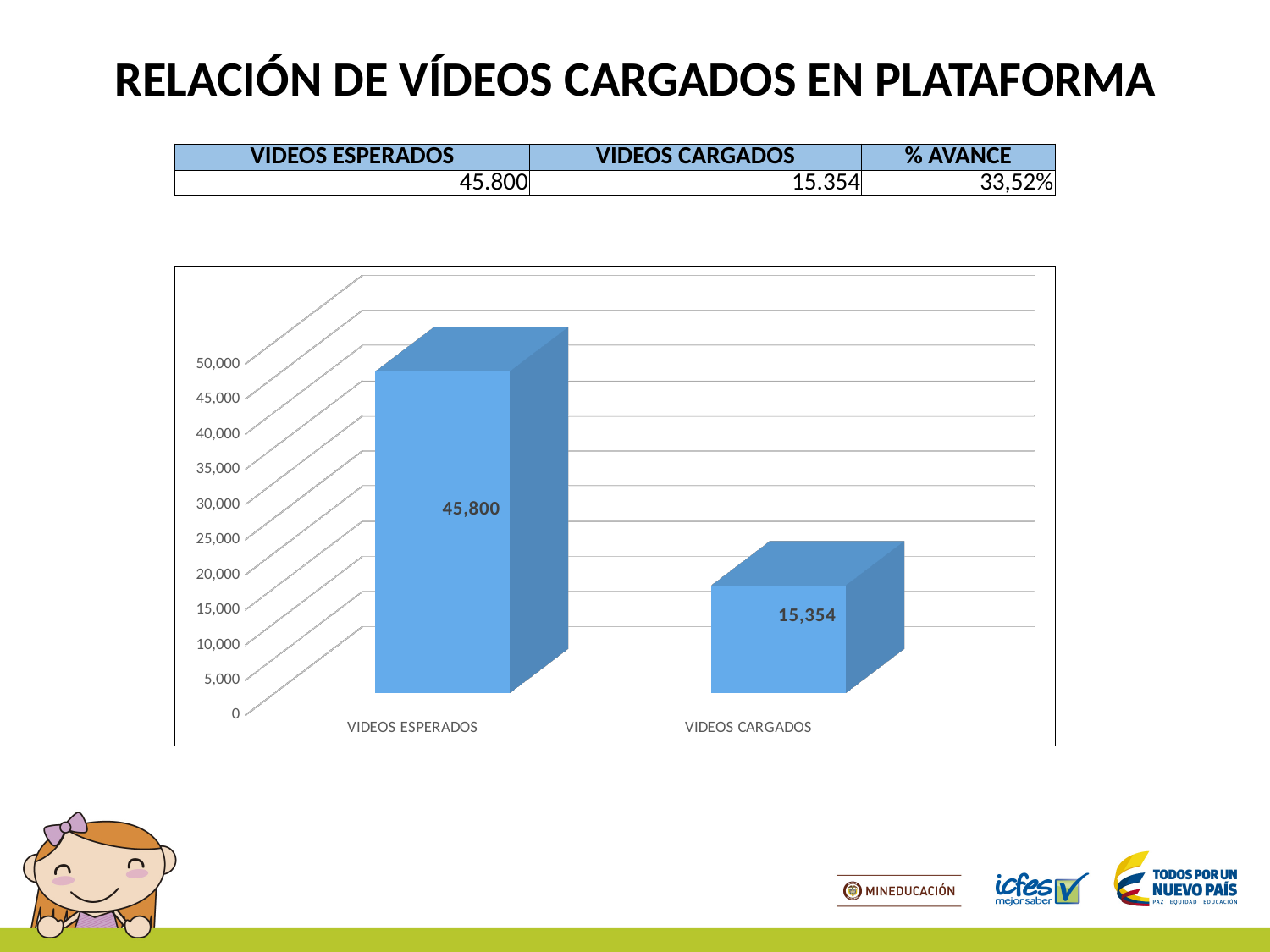
What is the value for VIDEOS CARGADOS in the chart? 15,354 What kind of chart is shown on the slide? bar chart What is the title of the slide containing the chart? RELACIÓN DE VÍDEOS CARGADOS EN PLATAFORMA What is the difference between the values for VIDEOS ESPERADOS and VIDEOS CARGADOS? 30,446 Do the values rise or fall from VIDEOS ESPERADOS to VIDEOS CARGADOS? fall Is the value for VIDEOS ESPERADOS greater or less than 40,000? greater Which category has the lowest value in the chart? VIDEOS CARGADOS Which category has the highest value in the chart? VIDEOS ESPERADOS Which is larger, the value for VIDEOS ESPERADOS or the value for VIDEOS CARGADOS? VIDEOS ESPERADOS What is the value for VIDEOS ESPERADOS in the chart? 45,800 How many categories are shown in the chart? 2 Is the value for VIDEOS CARGADOS greater or less than 20,000? less